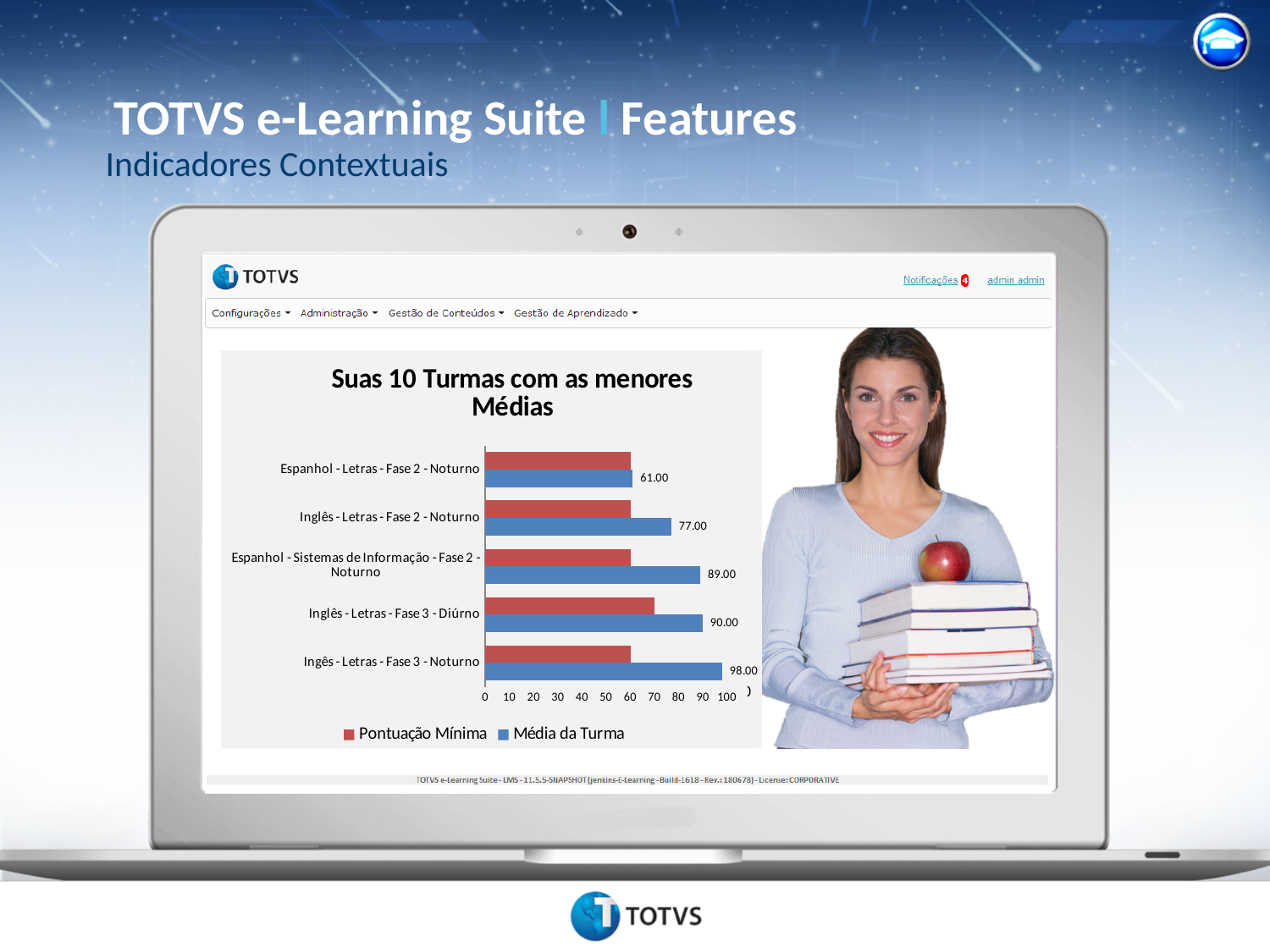
Which class has the highest Média da Turma? Ingês - Letras - Fase 3 - Noturno What is the difference between the Média da Turma of Ingês - Letras - Fase 3 - Noturno and Espanhol - Letras - Fase 2 - Noturno? 37.00 What kind of chart is shown on the slide? Bar chart What is the Média da Turma value for Espanhol - Letras - Fase 2 - Noturno? 61.00 Is the Pontuação Mínima for Inglês - Letras - Fase 3 - Diúrno greater or less than 80? less Which has a larger Média da Turma: Inglês - Letras - Fase 2 - Noturno or Espanhol - Sistemas de Informação - Fase 2 - Noturno? Espanhol - Sistemas de Informação - Fase 2 - Noturno What is the Média da Turma value for Inglês - Letras - Fase 2 - Noturno? 77.00 How many classes are shown in the chart? 5 What is the Média da Turma value for Inglês - Letras - Fase 3 - Diúrno? 90.00 How many series does the legend list? 2 Which class has the lowest Média da Turma? Espanhol - Letras - Fase 2 - Noturno What is the title of the chart? Suas 10 Turmas com as menores Médias